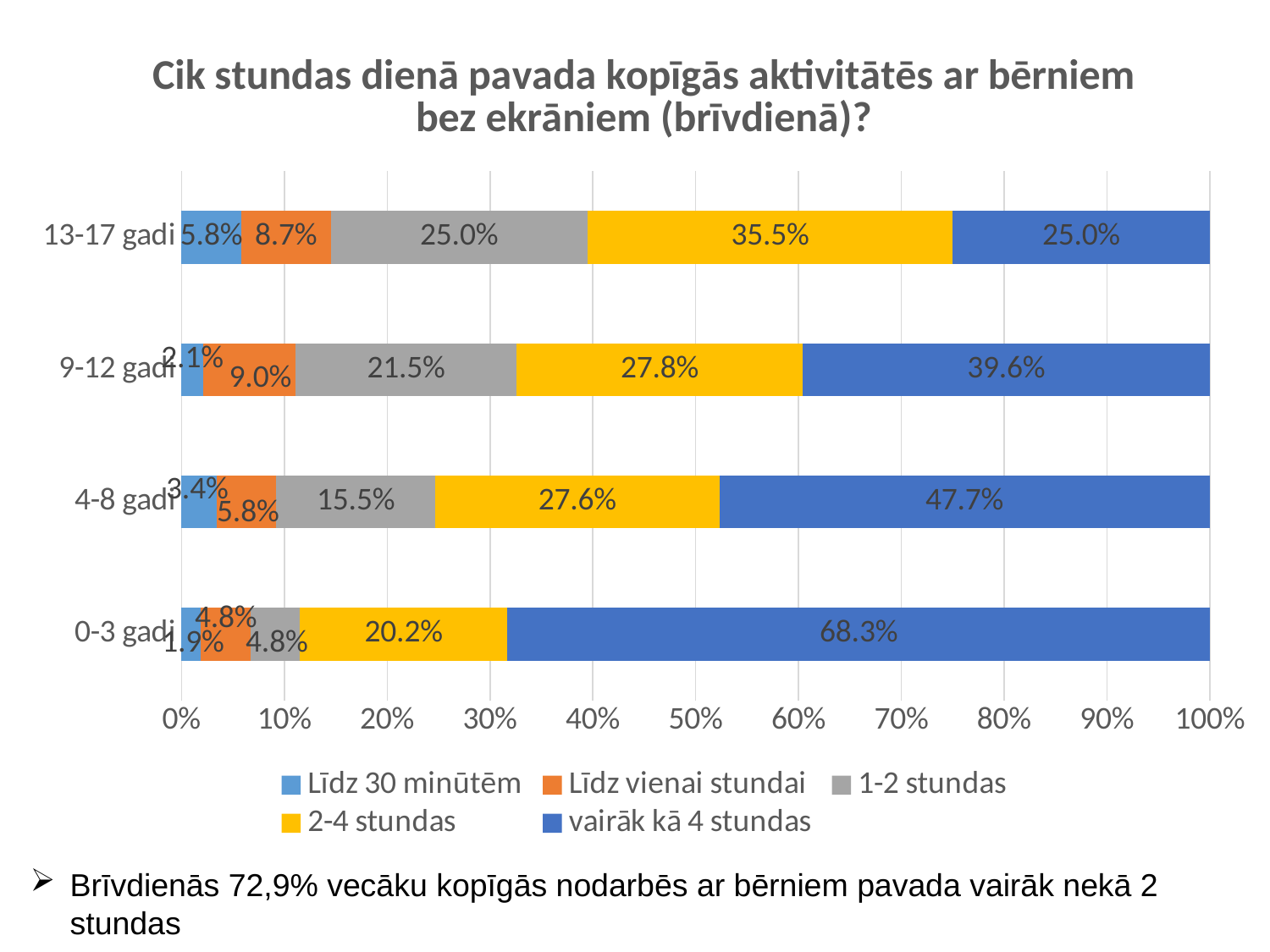
How many age categories are shown on the chart? 4 Which age category has the highest value for 'vairāk kā 4 stundas'? 0-3 gadi What is the value for '2-4 stundas' in the 13-17 gadi category? 35.5% What is the title of the chart? Cik stundas dienā pavada kopīgās aktivitātēs ar bērniem bez ekrāniem (brīvdienā)? What type of chart is shown on the slide? Stacked bar chart What is the value for 'vairāk kā 4 stundas' in the 0-3 gadi category? 68.3% What is the value for '1-2 stundas' in the 9-12 gadi category? 21.5% What is the difference between the 'vairāk kā 4 stundas' values for 4-8 gadi and 9-12 gadi? 8.1% Which age category has the lowest value for 'Līdz 30 minūtēm'? 0-3 gadi Which is larger: the '2-4 stundas' value for 9-12 gadi or for 4-8 gadi? 9-12 gadi How many series does the legend list? 5 What is the value for 'Līdz vienai stundai' in the 4-8 gadi category? 5.8%